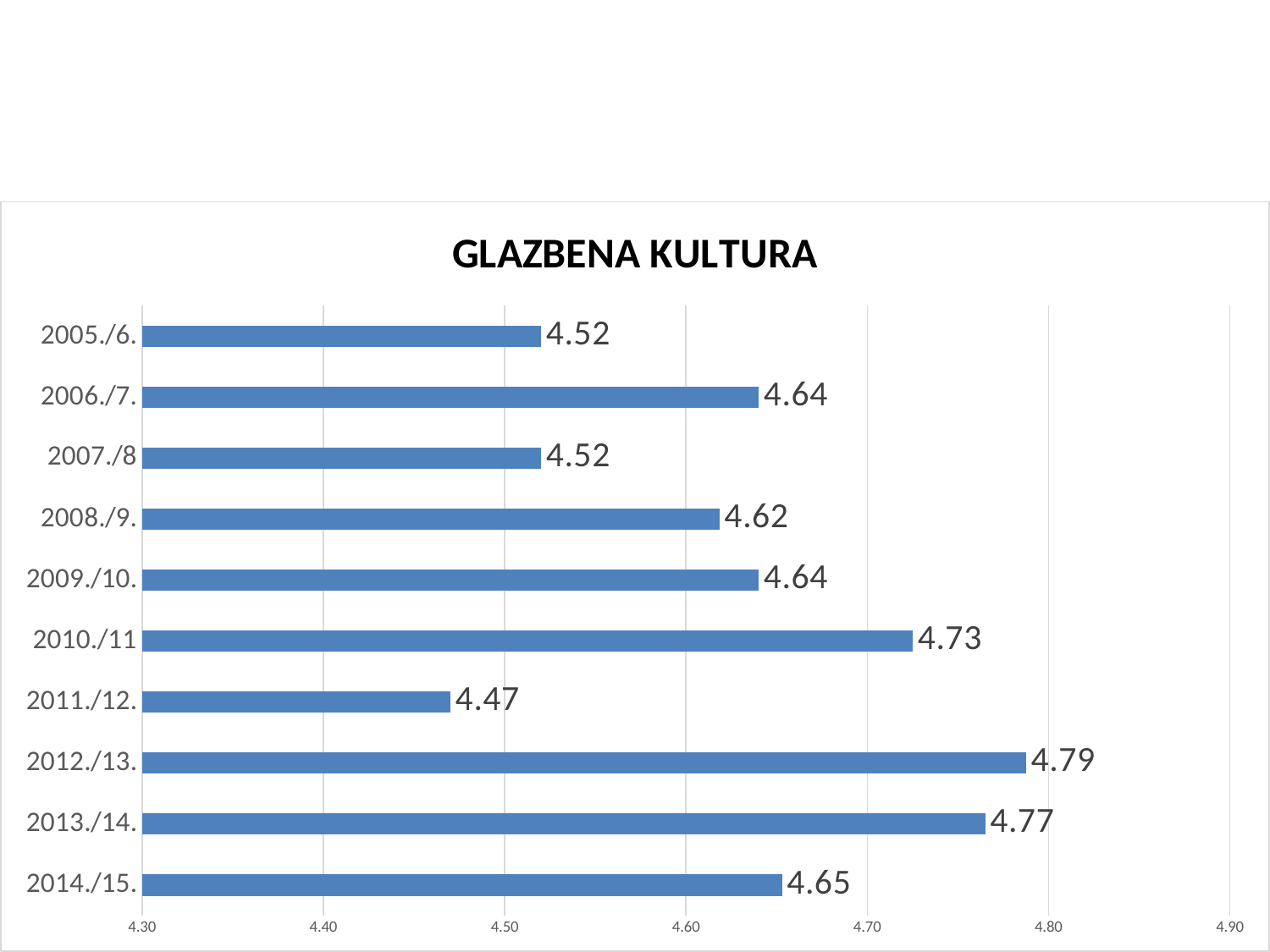
What is the title of the chart? GLAZBENA KULTURA Which school year has the lowest value? 2011./12. Which school year has the highest value? 2012./13. How many school years are shown in the chart? 10 What is the value for 2014./15.? 4.65 What is the difference between the values for 2012./13. and 2011./12.? 0.32 Is the value for 2010./11 greater or less than 4.70? greater What kind of chart is shown? bar chart What is the difference between the values for 2013./14. and 2014./15.? 0.12 Which is larger, the value for 2008./9. or the value for 2009./10.? 2009./10. What is the value for 2010./11? 4.73 What is the value for 2011./12.? 4.47